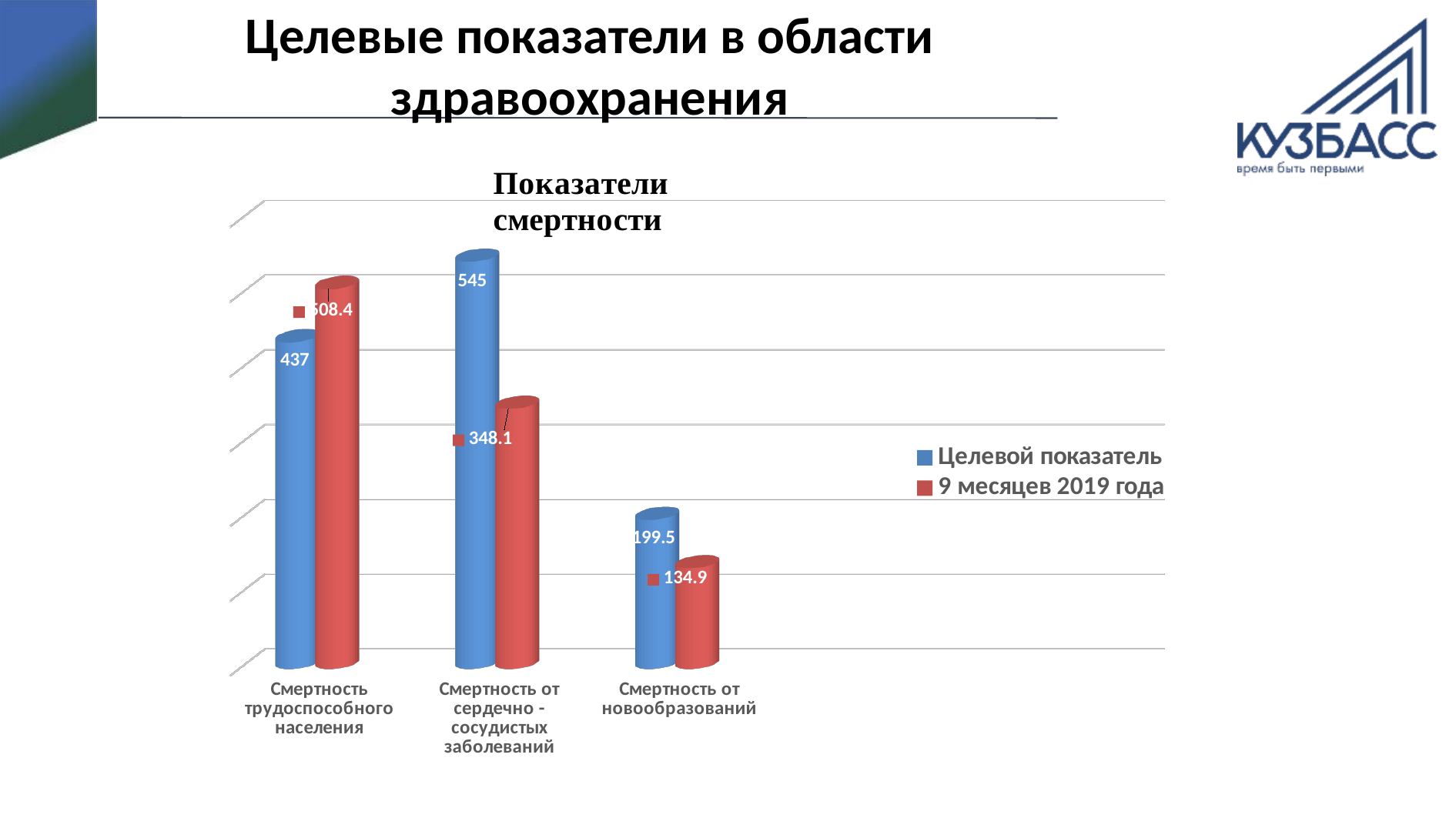
What is the value of "Целевой показатель" for "Смертность от сердечно-сосудистых заболеваний"? 545 Which category has the highest value for "Целевой показатель"? Смертность от сердечно-сосудистых заболеваний How many series does the legend of the chart list? 2 How many categories are shown on the x axis of the chart? 3 For "Смертность трудоспособного населения", which series has the larger value: "Целевой показатель" or "9 месяцев 2019 года"? 9 месяцев 2019 года What is the value of "9 месяцев 2019 года" for "Смертность от сердечно-сосудистых заболеваний"? 348.1 What is the value of "9 месяцев 2019 года" for "Смертность от новообразований"? 134.9 What is the value of "Целевой показатель" for "Смертность от новообразований"? 199.5 Which category has the lowest value for "9 месяцев 2019 года"? Смертность от новообразований What is the value of "Целевой показатель" for "Смертность трудоспособного населения"? 437 What is the difference between "Целевой показатель" and "9 месяцев 2019 года" for "Смертность от сердечно-сосудистых заболеваний"? 196.9 What kind of chart is shown on the slide? bar chart